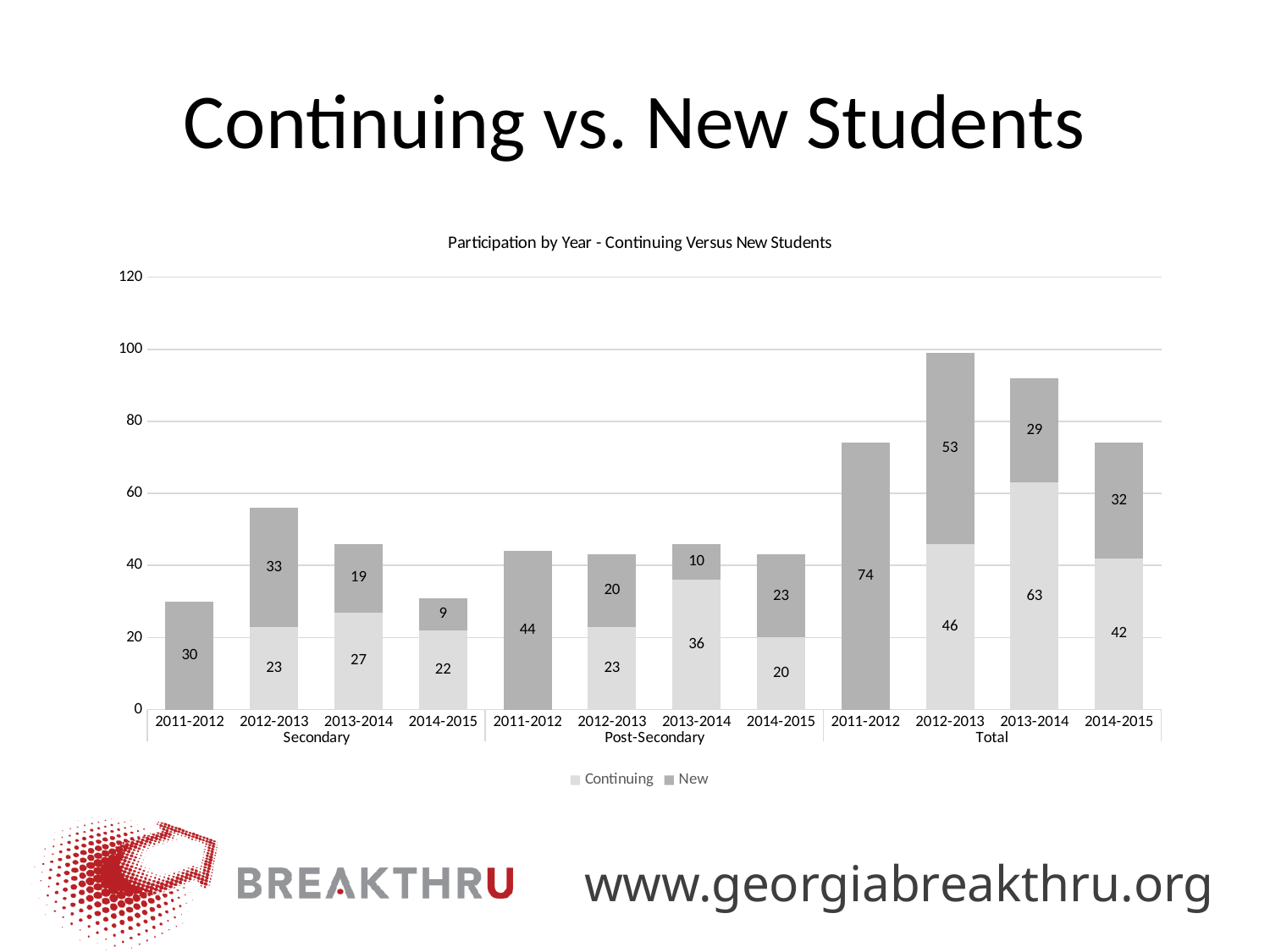
What is the value for New students in Secondary for 2012-2013? 33 What is the total of the stacked bar for Total 2012-2013? 99 What is the total of the stacked bar for Secondary 2012-2013? 56 What type of chart is shown on the slide? Stacked bar chart Is the total stacked bar for Total 2014-2015 greater or less than 60? greater What is the title of the chart? Participation by Year - Continuing Versus New Students Which year has the lowest value for New students in the Secondary group? 2014-2015 Which is larger in Post-Secondary 2014-2015: Continuing or New students? New How many series does the legend list? 2 What is the value for Continuing students in Post-Secondary for 2013-2014? 36 What is the difference between Continuing and New students in the Total group for 2013-2014? 34 What is the value for New students in the Total group for 2011-2012? 74